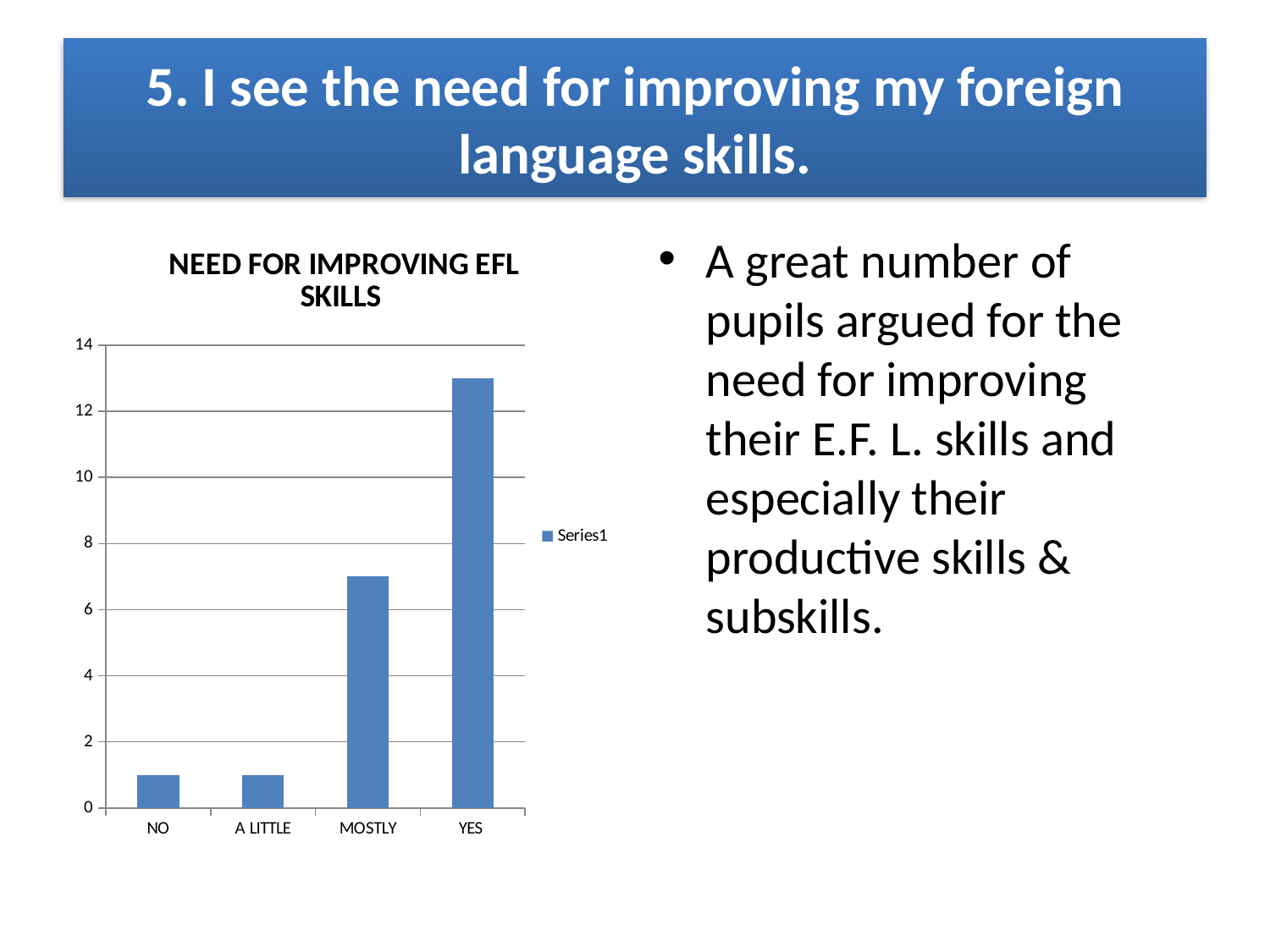
Is the value for NO greater or less than 2? less What is the title of the chart? NEED FOR IMPROVING EFL SKILLS Is the value for MOSTLY greater or less than 6? greater Do the values generally rise or fall moving from NO to YES along the x axis? rise What is the name of the series shown in the legend? Series1 Is the value for A LITTLE greater or less than 4? less What kind of chart is shown on the slide? bar chart How many categories are shown on the x axis of the chart? 4 How many series does the chart legend list? 1 Which is larger, the value for MOSTLY or the value for YES? YES Which category has the highest bar? YES